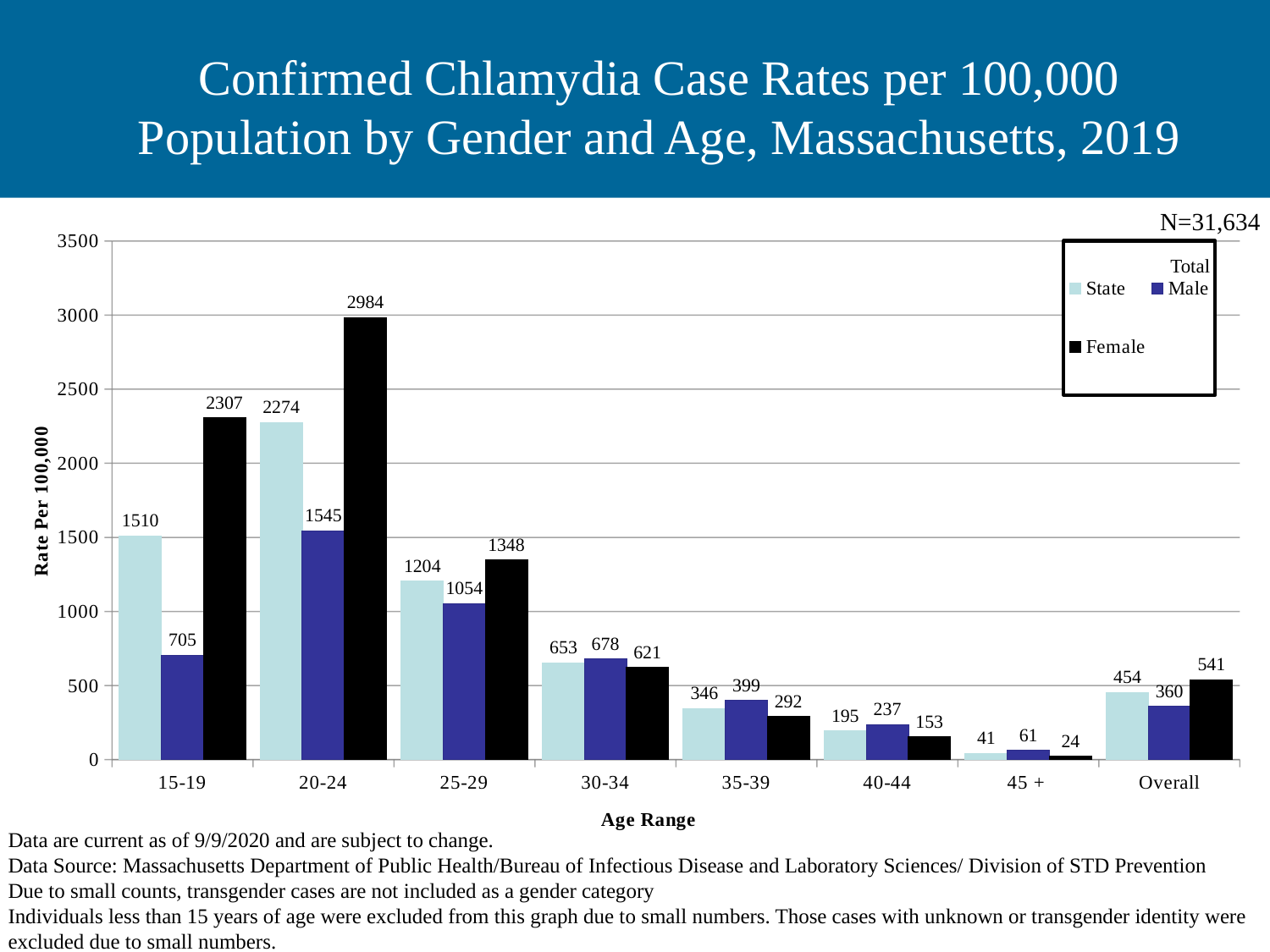
Which age range has the highest Female case rate? 20-24 What is the N value shown above the chart? N=31,634 How many series does the legend list? 3 What is the Female chlamydia case rate for the 20-24 age range? 2984 How many age range categories are shown on the x axis? 8 What is the State Total chlamydia case rate for the 25-29 age range? 1204 From the 20-24 age range to the 45 + age range, do the Female case rates rise or fall? Fall What is the Male chlamydia case rate for the 15-19 age range? 705 Which age range has the lowest Male case rate? 45 + Which is larger for the 30-34 age range, the Male rate or the Female rate? Male What kind of chart is shown on the slide? Bar chart What is the difference between the Female and Male case rates for the 15-19 age range? 1602